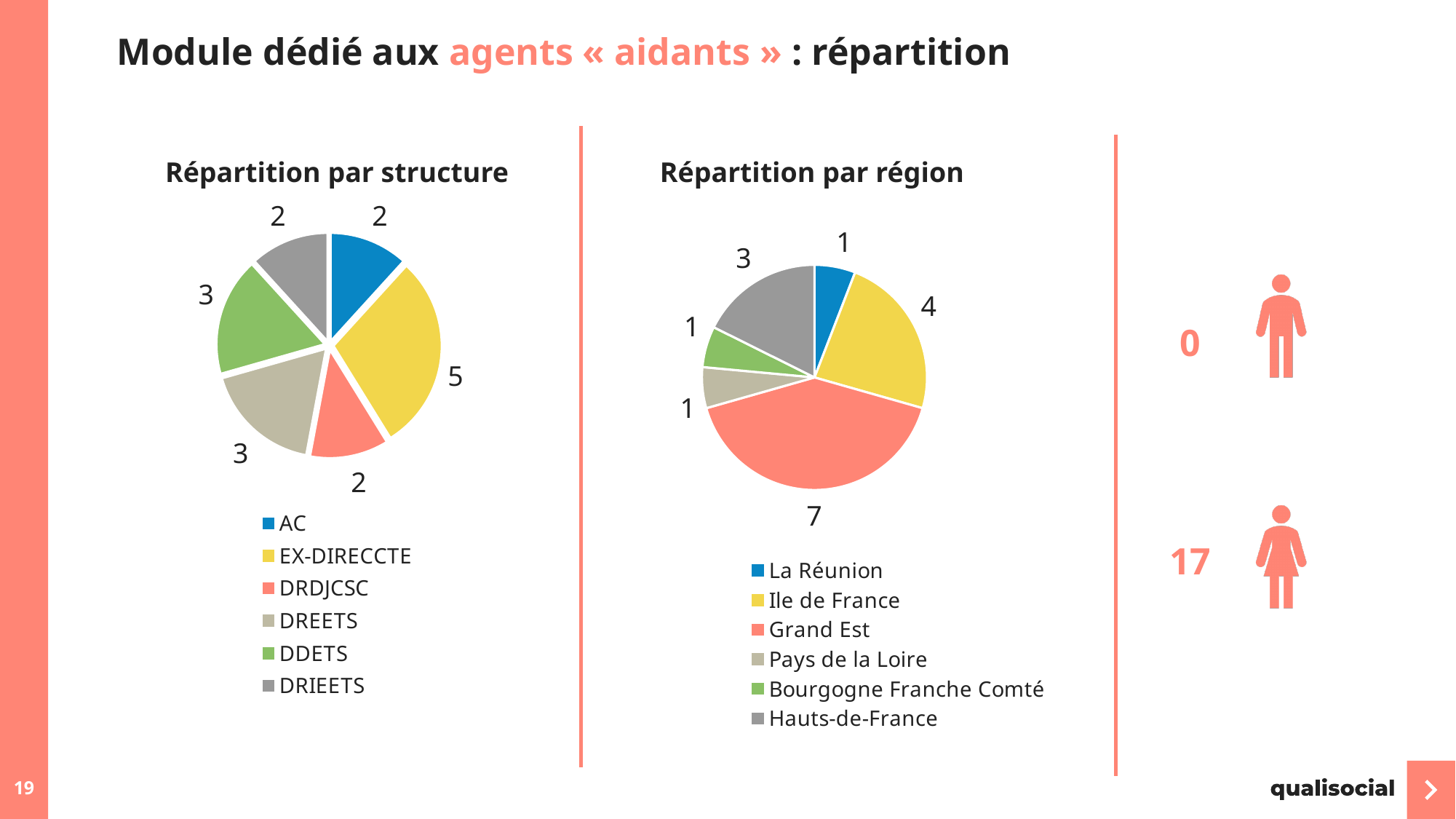
In the 'Répartition par structure' chart, which structure has the largest slice? EX-DIRECCTE In the 'Répartition par région' chart, what is the difference between the values for Grand Est and Ile de France? 3 In the 'Répartition par structure' chart, what is the value for EX-DIRECCTE? 5 In the 'Répartition par région' chart, which is larger, Ile de France or Hauts-de-France? Ile de France In the 'Répartition par structure' chart, how many categories does the legend list? 6 In the 'Répartition par structure' chart, what is the difference between the values for EX-DIRECCTE and DDETS? 2 In the 'Répartition par structure' chart, what is the value for DREETS? 3 What type of chart is the 'Répartition par région' chart? Pie chart In the 'Répartition par région' chart, which region has the largest slice? Grand Est In the 'Répartition par région' chart, what is the value for Ile de France? 4 In the 'Répartition par région' chart, what is the value for Grand Est? 7 In the 'Répartition par région' chart, what is the value for Hauts-de-France? 3